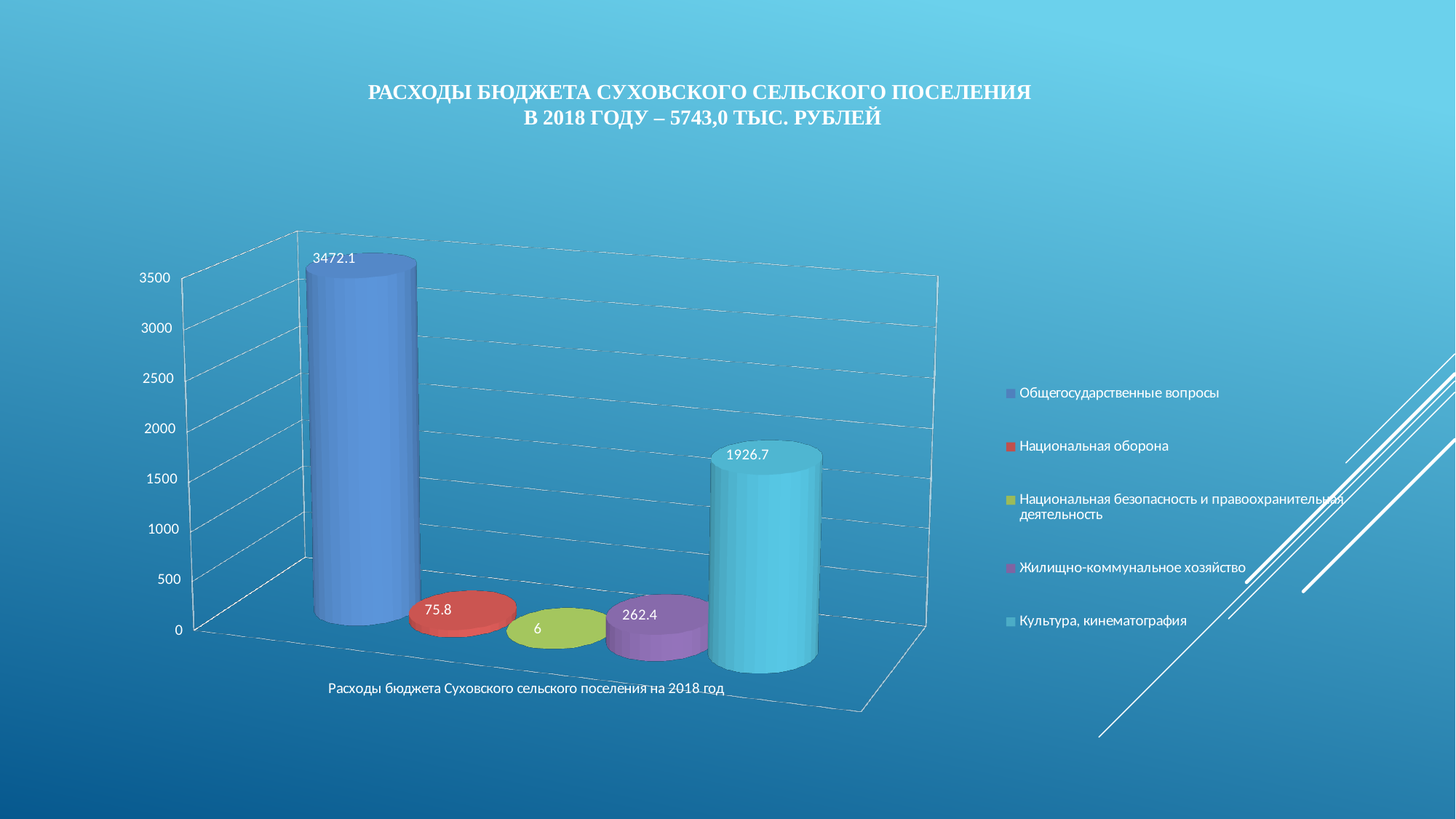
How many series does the legend list? 5 What type of chart is shown on the slide? Bar chart What is the difference between the values for Общегосударственные вопросы and Культура, кинематография? 1545.4 What is the value for Культура, кинематография? 1926.7 Which is larger, the value for Жилищно-коммунальное хозяйство or the value for Национальная оборона? Жилищно-коммунальное хозяйство What is the value for Жилищно-коммунальное хозяйство? 262.4 Which series has the highest value? Общегосударственные вопросы Which series has the lowest value? Национальная безопасность и правоохранительная деятельность What is the value for Общегосударственные вопросы? 3472.1 What total amount is stated in the slide title for the 2018 budget expenditures? 5743,0 тыс. рублей What is the value for Национальная безопасность и правоохранительная деятельность? 6 What is the value for Национальная оборона? 75.8